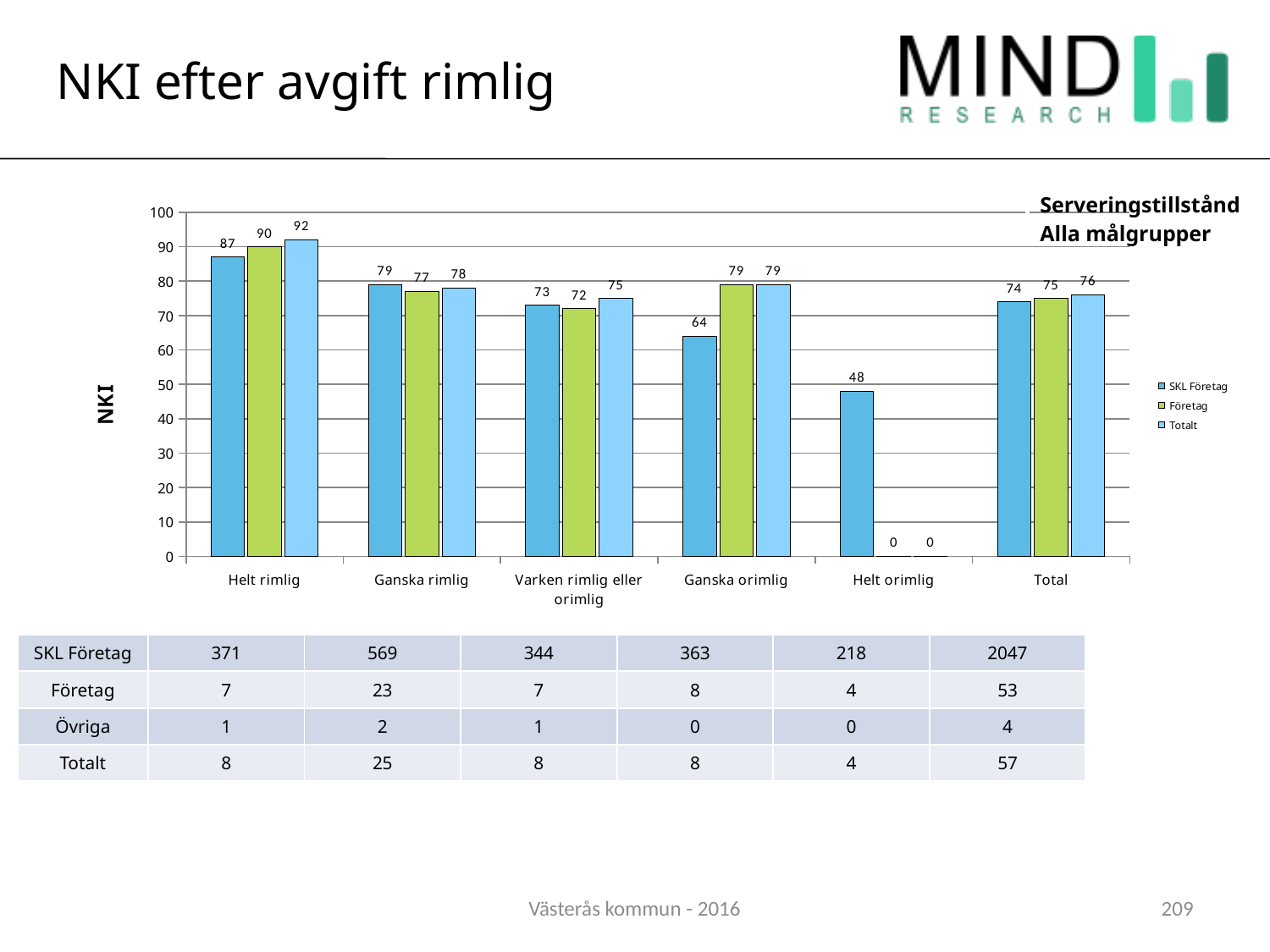
Which is larger in the Ganska orimlig category: the SKL Företag value or the Företag value? Företag Which category has the highest NKI value for the Totalt series? Helt rimlig What is the difference between the Totalt value for Helt rimlig and the Totalt value for Total? 16 What kind of chart is shown on the slide? bar chart Is the SKL Företag value for Helt orimlig greater or less than 50? less What is the NKI value for SKL Företag in the Helt rimlig category? 87 Which category has the lowest NKI value for the SKL Företag series? Helt orimlig What is the label on the y axis of the chart? NKI How many categories are shown on the x axis of the chart? 6 How many series does the chart legend list? 3 What is the NKI value for Totalt in the Ganska orimlig category? 79 What is the NKI value for Företag in the Total category? 75